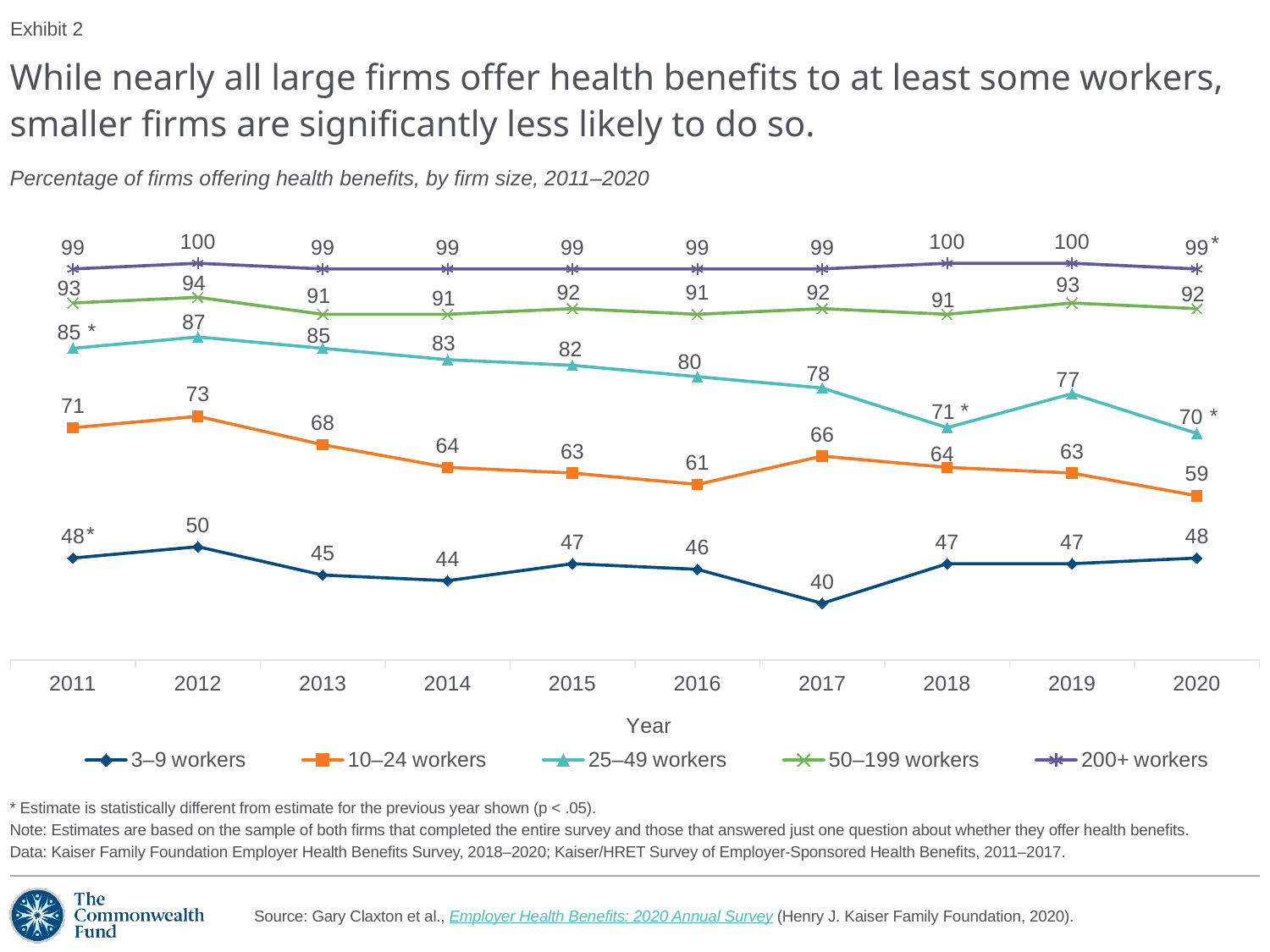
What is the difference between the 25–49 workers value in 2019 and in 2020? 7 What is the value for 3–9 workers in 2017? 40 What is the value for 25–49 workers in 2012? 87 How many years are plotted on the x axis? 10 What is the value for 10–24 workers in 2020? 59 In which year is the value for 10–24 workers highest? 2012 How many series does the legend list? 5 Which is larger in 2018: the value for 25–49 workers or the value for 10–24 workers? 25–49 workers Does the value for 10–24 workers rise or fall from 2017 to 2020? Fall What kind of chart is shown? Line chart In which year is the value for 3–9 workers lowest? 2017 What is the x-axis title of the chart? Year